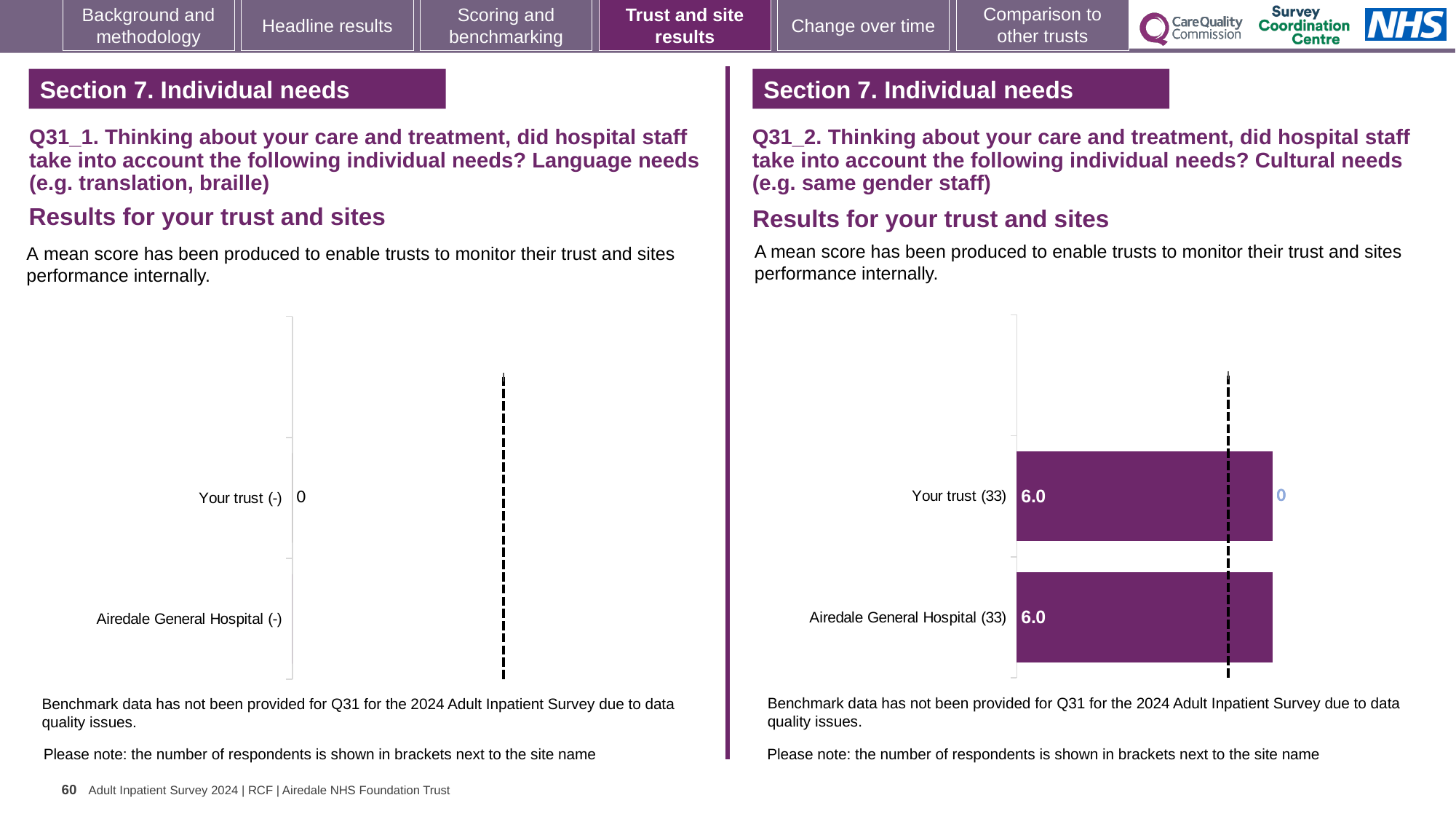
On the right chart (Q31_2, Cultural needs), what is the difference between the scores for Your trust (33) and Airedale General Hospital (33)? 0.0 How many categories are listed on the left chart (Q31_1, Language needs)? 2 How many categories are plotted on the right chart (Q31_2, Cultural needs)? 2 On the left chart (Q31_1, Language needs), what is shown in brackets next to Airedale General Hospital? - On the right chart (Q31_2, Cultural needs), what is the mean score for Airedale General Hospital (33)? 6.0 What kind of chart is the right chart (Q31_2, Cultural needs)? Bar chart On the right chart (Q31_2, Cultural needs), what colour are the bars? Purple On the right chart (Q31_2, Cultural needs), how many respondents are shown in brackets next to Your trust? 33 On the left chart (Q31_1, Language needs), what value is shown for Your trust (-)? 0 On the right chart (Q31_2, Cultural needs), what is the mean score for Your trust (33)? 6.0